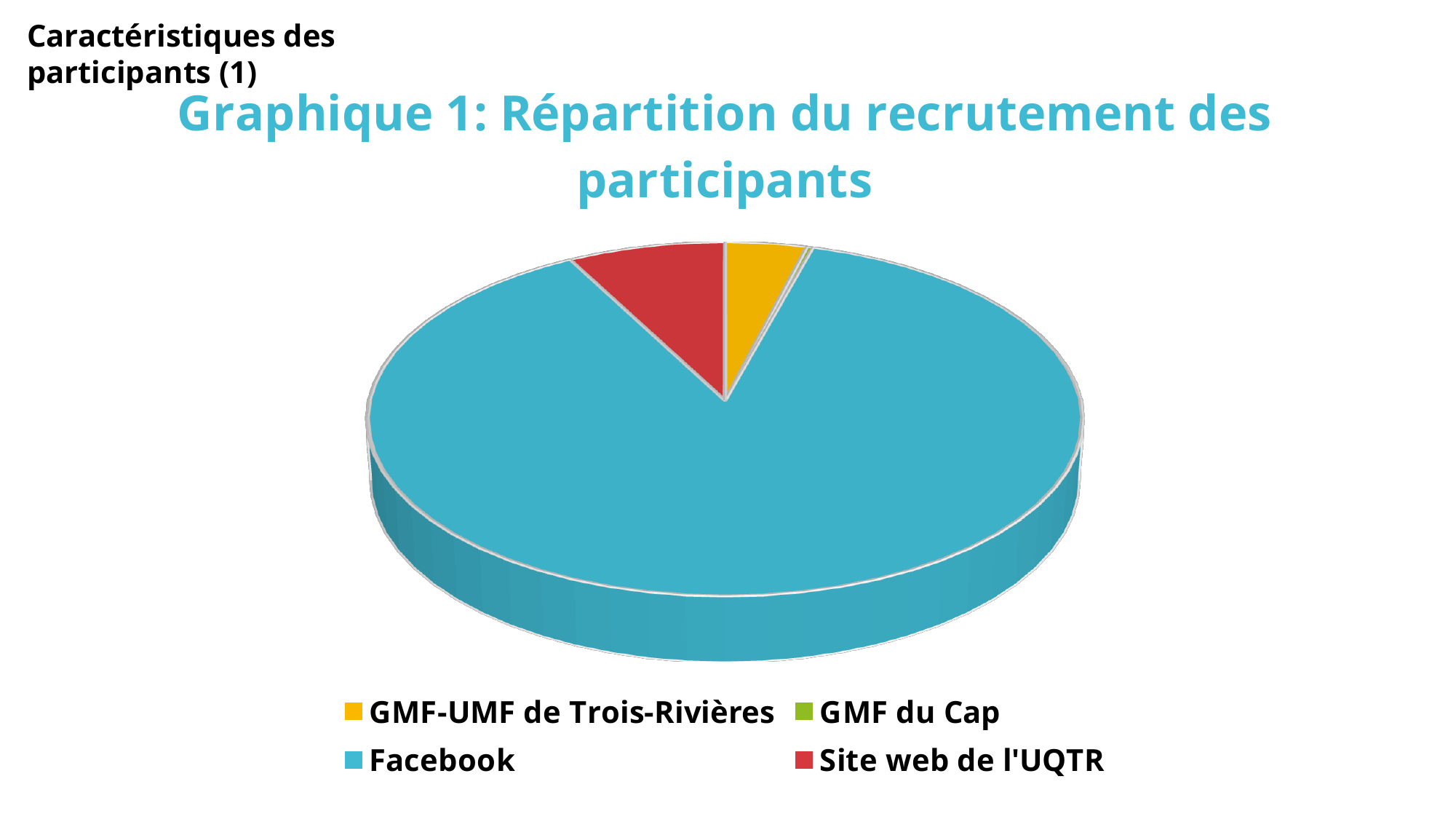
What kind of chart is shown on the slide? Pie chart Which category has the smallest share of the pie? GMF du Cap Which colour represents Site web de l'UQTR in the pie chart? Red Which category has the largest share of the pie? Facebook Which is larger, the share for Facebook or the share for Site web de l'UQTR? Facebook What is the title of the chart? Graphique 1: Répartition du recrutement des participants Which is larger, the share for Site web de l'UQTR or the share for GMF-UMF de Trois-Rivières? Site web de l'UQTR Which is larger, the share for GMF-UMF de Trois-Rivières or the share for GMF du Cap? GMF-UMF de Trois-Rivières How many categories does the pie chart show? 4